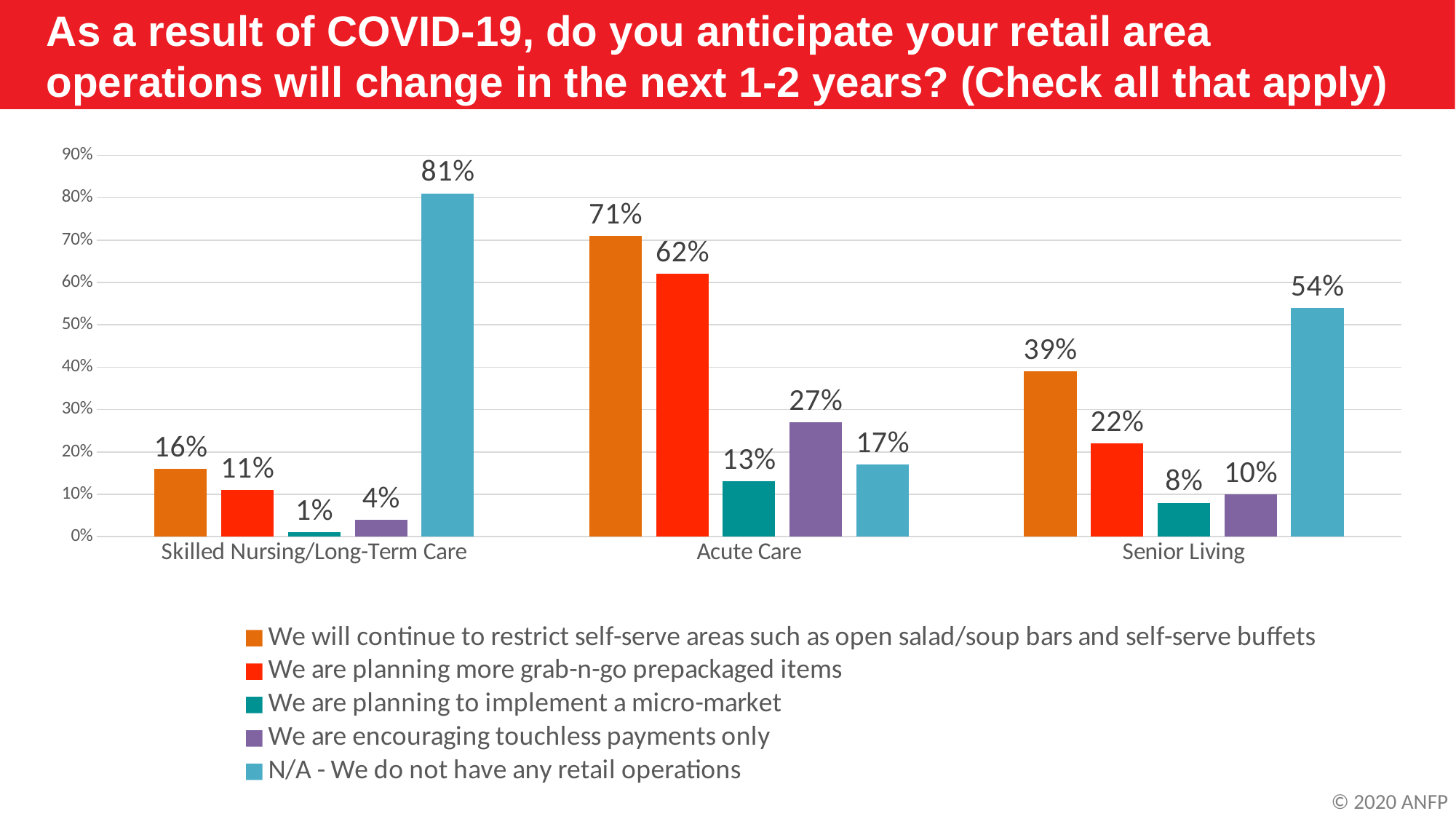
How many categories are shown on the x axis? 3 Which category has the highest value for 'We are planning to implement a micro-market'? Acute Care How many series does the legend list? 5 What is the value for 'We are encouraging touchless payments only' in the Acute Care category? 27% Which category has the lowest value for 'We are planning more grab-n-go prepackaged items'? Skilled Nursing/Long-Term Care Which is larger in the Acute Care category: 'We are planning more grab-n-go prepackaged items' or 'We are encouraging touchless payments only'? We are planning more grab-n-go prepackaged items What percentage of Acute Care respondents said they will continue to restrict self-serve areas such as open salad/soup bars and self-serve buffets? 71% What colour represents 'We are encouraging touchless payments only' in the legend? Purple What is the difference between the 'N/A - We do not have any retail operations' values for Skilled Nursing/Long-Term Care and Senior Living? 27% What percentage of Senior Living respondents are planning more grab-n-go prepackaged items? 22% What kind of chart is shown on the slide? Bar chart What is the value for 'N/A - We do not have any retail operations' in the Skilled Nursing/Long-Term Care category? 81%